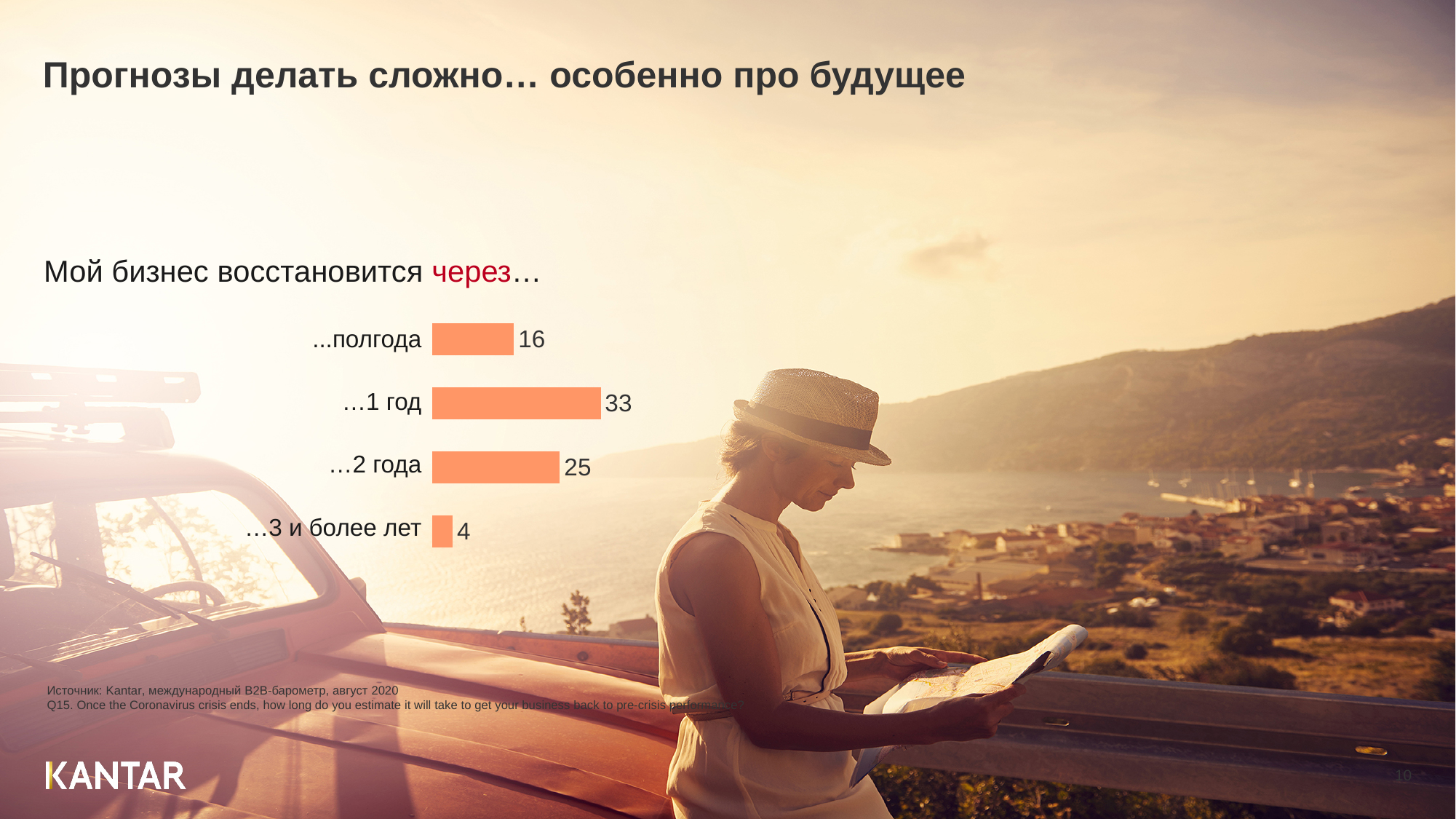
What is the difference between the values for "…1 год" and "…2 года"? 8 What is the value for "...полгода"? 16 What is the value for "…3 и более лет"? 4 What is the value for "…1 год"? 33 Which is larger, the value for "...полгода" or the value for "…2 года"? …2 года Which category has the lowest value? …3 и более лет How many categories does the chart show? 4 What is the difference between the values for "...полгода" and "…3 и более лет"? 12 What is the heading text above the chart? Мой бизнес восстановится через… Which category has the highest value? …1 год What kind of chart is shown on the slide? Bar chart What is the value for "…2 года"? 25